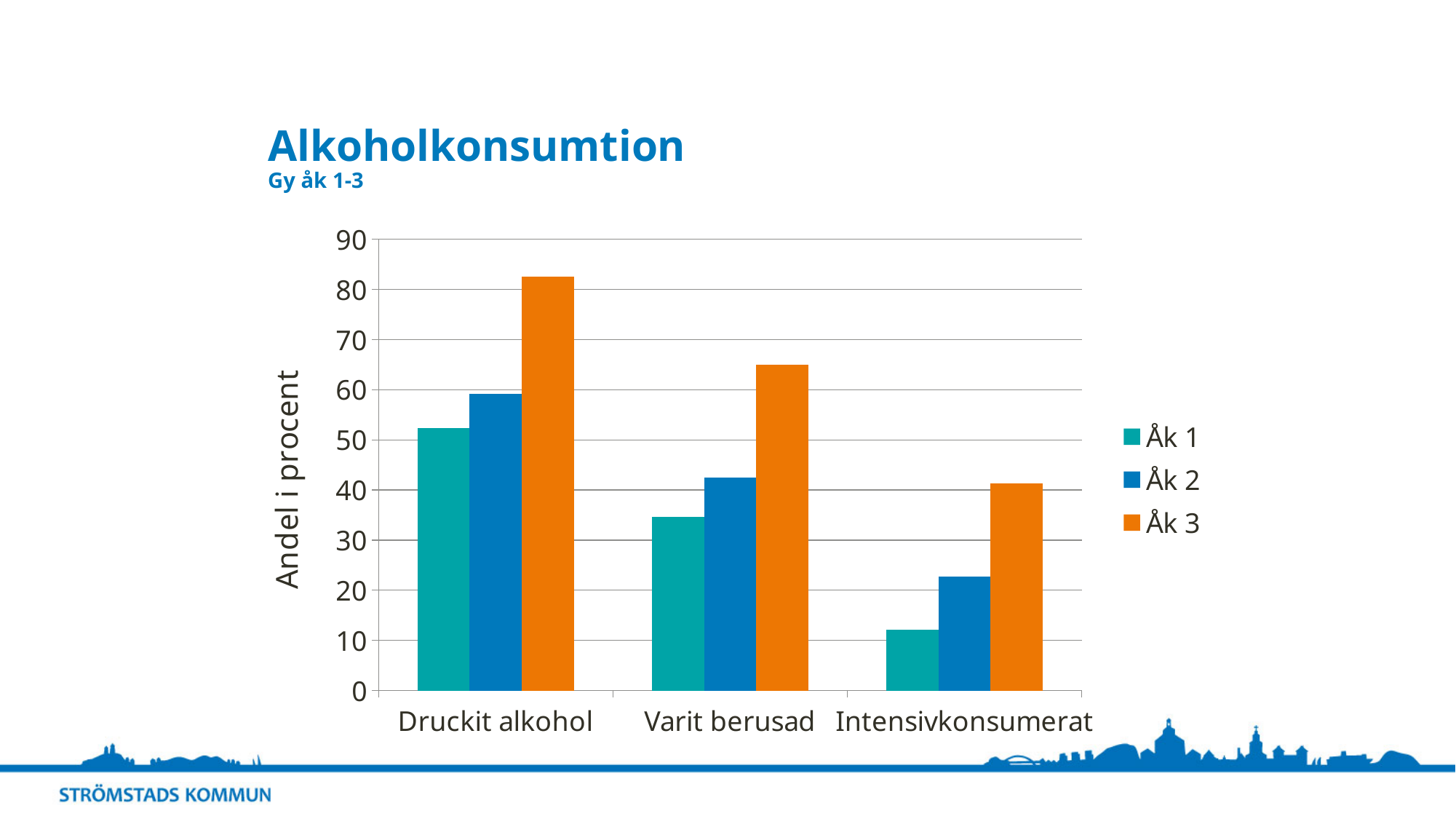
Is the value for Åk 3 in Varit berusad greater or less than 60? greater Is the value for Åk 3 in Druckit alkohol greater or less than 70? greater Which category has the lowest value for Åk 1? Intensivkonsumerat Is the value for Åk 1 in Intensivkonsumerat greater or less than 20? less How many series does the legend list? 3 Which category has the highest value for Åk 3? Druckit alkohol What is the label of the y axis? Andel i procent Which series has the highest value in the Varit berusad category? Åk 3 What kind of chart is shown on the slide? bar chart Do the Åk 1 values rise or fall from Druckit alkohol to Intensivkonsumerat? fall Which is larger: Åk 2 in Druckit alkohol or Åk 2 in Varit berusad? Åk 2 in Druckit alkohol How many categories are shown on the x axis? 3